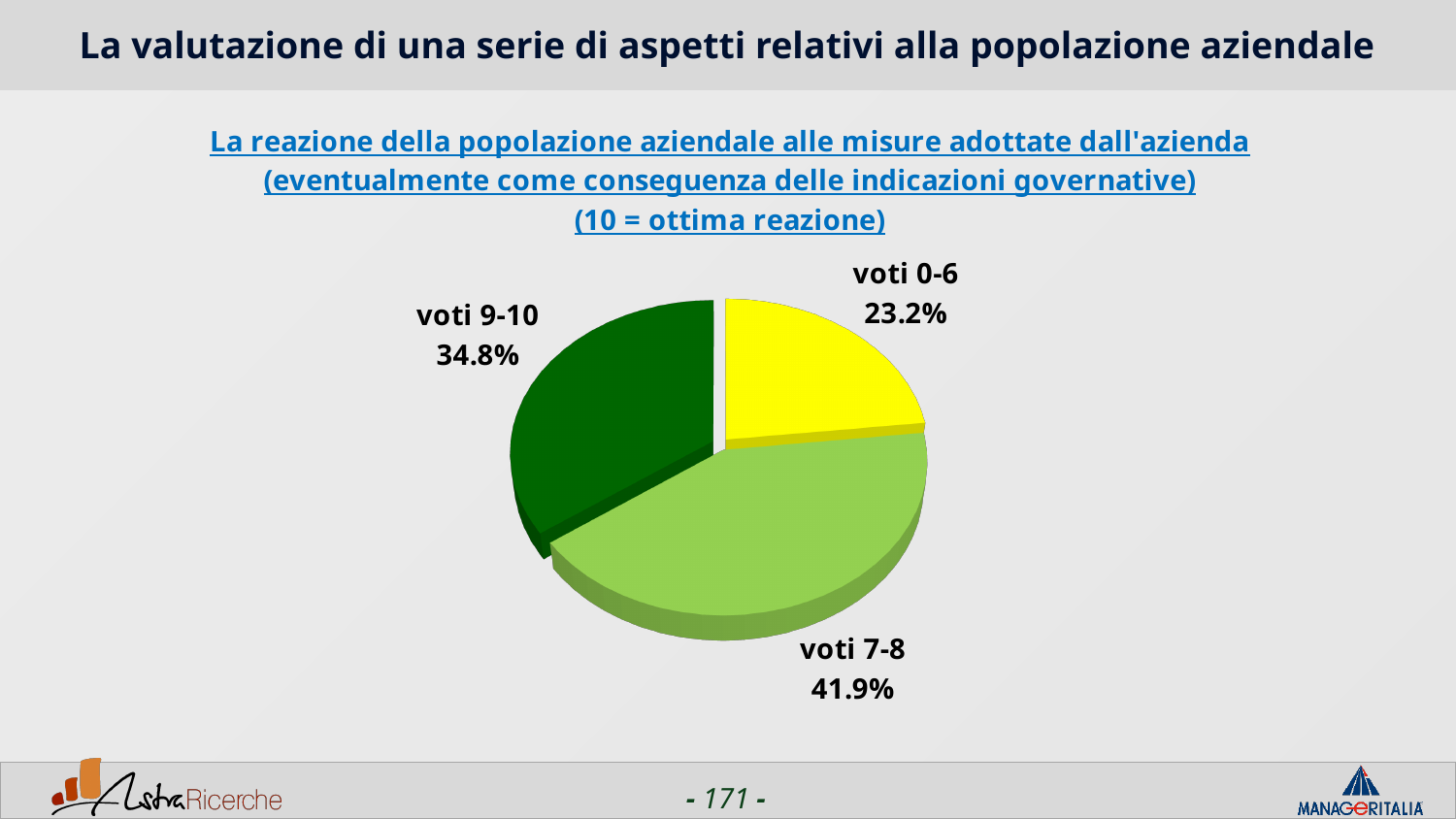
Which is larger, the "voti 9-10" slice or the "voti 0-6" slice? voti 9-10 Which slice of the pie is the largest? voti 7-8 What is the difference in percentage points between the "voti 7-8" slice and the "voti 0-6" slice? 18.7 How many slices does the pie chart have? 3 What colour is the "voti 0-6" slice? yellow What kind of chart is shown on the slide? pie chart What share of the pie is labelled "voti 9-10"? 34.8% What is the difference in percentage points between the "voti 9-10" slice and the "voti 0-6" slice? 11.6 What share of the pie is labelled "voti 7-8"? 41.9% What share of the pie is labelled "voti 0-6"? 23.2% According to the chart subtitle, what score corresponds to "ottima reazione"? 10 Which slice of the pie is the smallest? voti 0-6